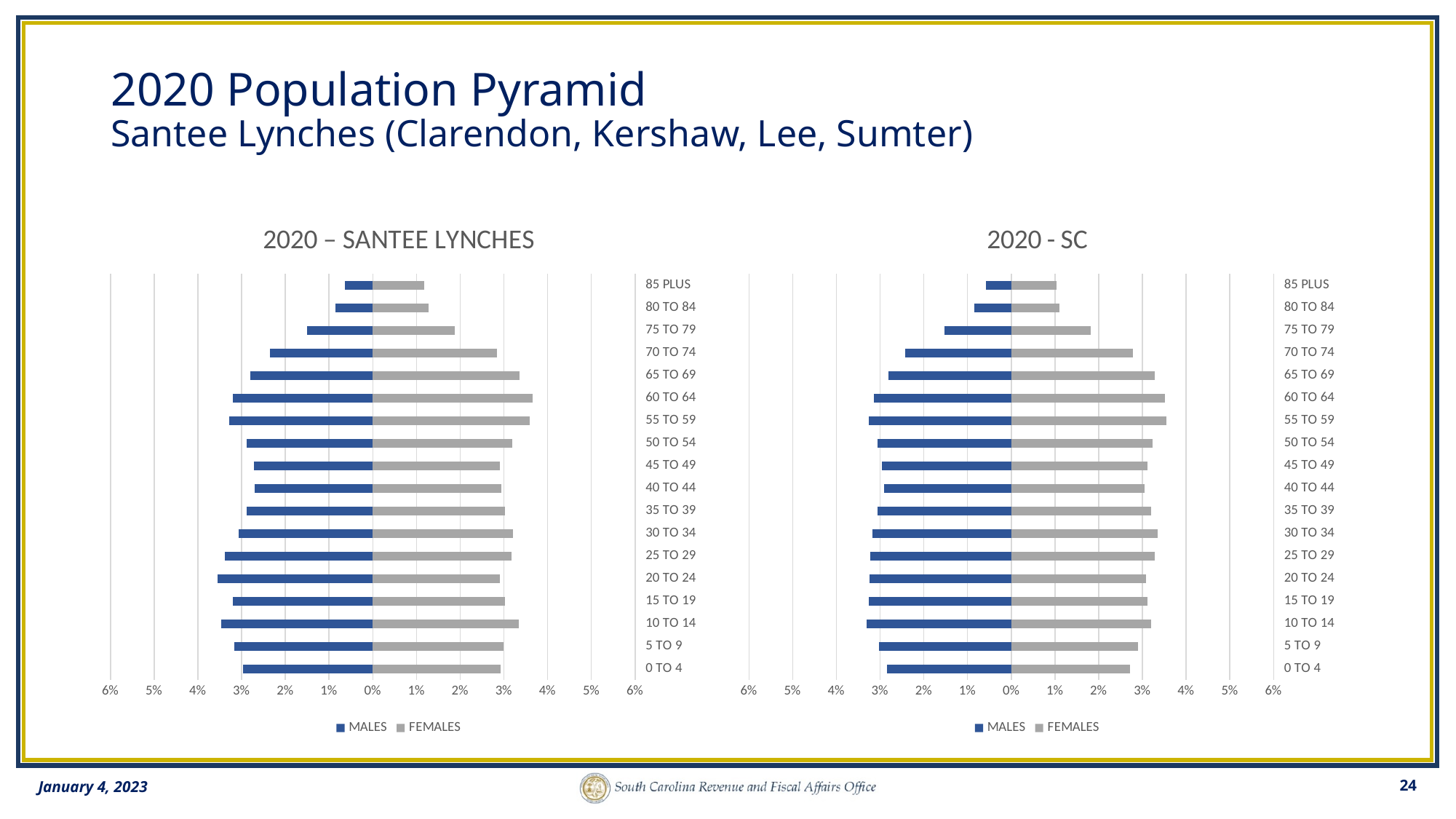
On the 2020 – SANTEE LYNCHES chart, which is larger for the 85 PLUS group, the MALES bar or the FEMALES bar? FEMALES How many series does the legend of the 2020 – SANTEE LYNCHES chart list? 2 What colour are the MALES bars on the 2020 - SC chart? blue On the 2020 - SC chart, which age group has the shortest MALES bar? 85 PLUS On the 2020 – SANTEE LYNCHES chart, is the MALES value for 85 PLUS greater or less than 1%? less On the 2020 - SC chart, is the MALES value for 75 TO 79 greater or less than 1%? greater What kind of chart is the 2020 – SANTEE LYNCHES chart? bar chart On the 2020 – SANTEE LYNCHES chart, which age group has the shortest MALES bar? 85 PLUS On the 2020 - SC chart, is the FEMALES value for 55 TO 59 greater or less than 3%? greater What are the two series named in the legend of the 2020 - SC chart? MALES and FEMALES How many age groups are shown on the 2020 - SC chart? 18